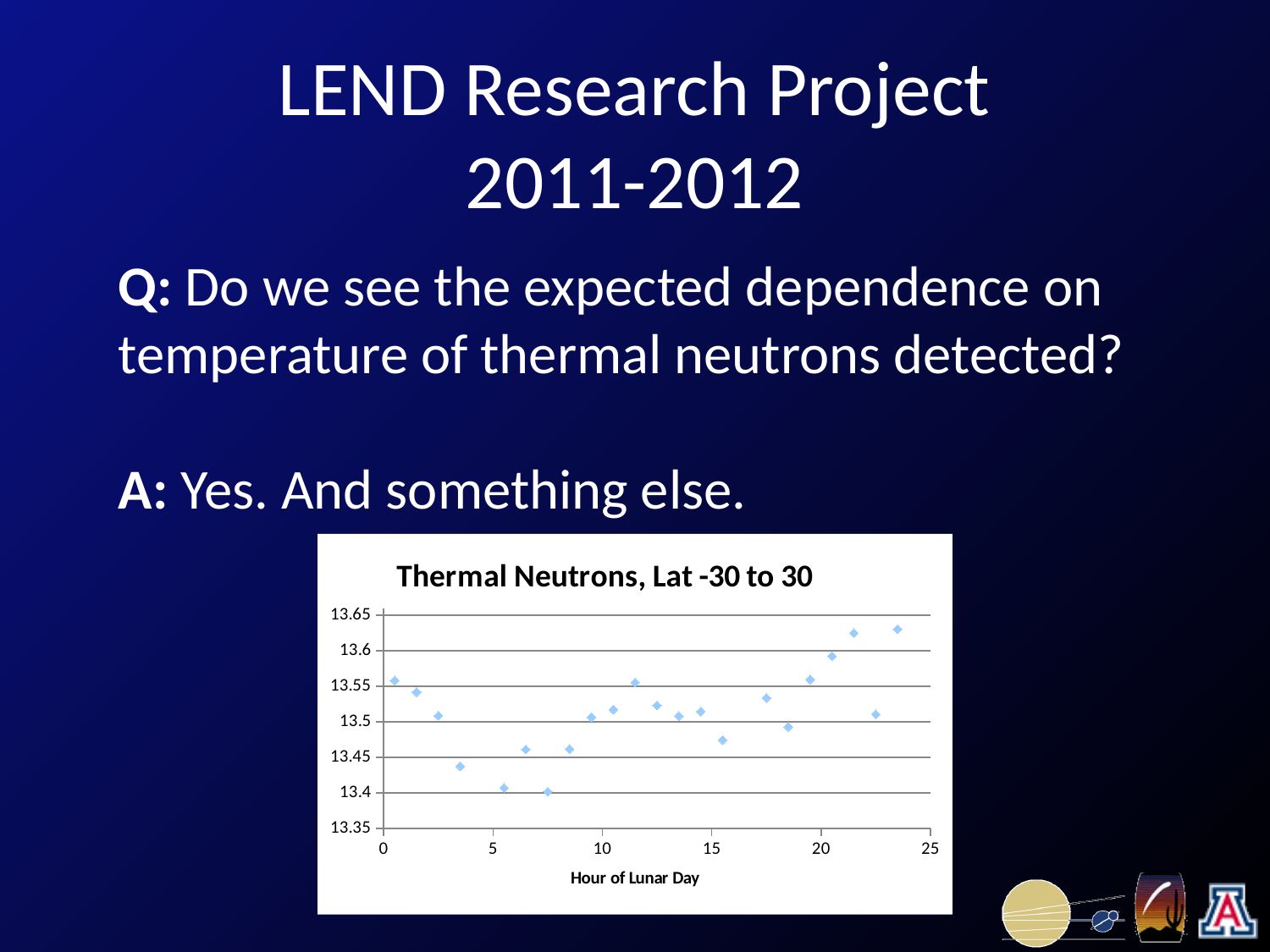
Is the value plotted at about hour 15.5 of the lunar day greater or less than 13.5? less What is the title of the chart? Thermal Neutrons, Lat -30 to 30 Which is larger: the value plotted at about hour 21.5 or the value at about hour 7.5? hour 21.5 Is the value plotted at about hour 3.5 of the lunar day greater or less than 13.45? less What kind of chart is shown on the slide? scatter chart Between hour 7.5 and hour 11.5 of the lunar day, do the plotted values generally rise or fall? rise Is the value plotted at about hour 21.5 of the lunar day greater or less than 13.6? greater Which is larger: the value plotted at about hour 3.5 or the value at about hour 11.5? hour 11.5 What is the label of the x axis of the chart? Hour of Lunar Day Between hour 0 and hour 7.5 of the lunar day, do the plotted values generally rise or fall? fall